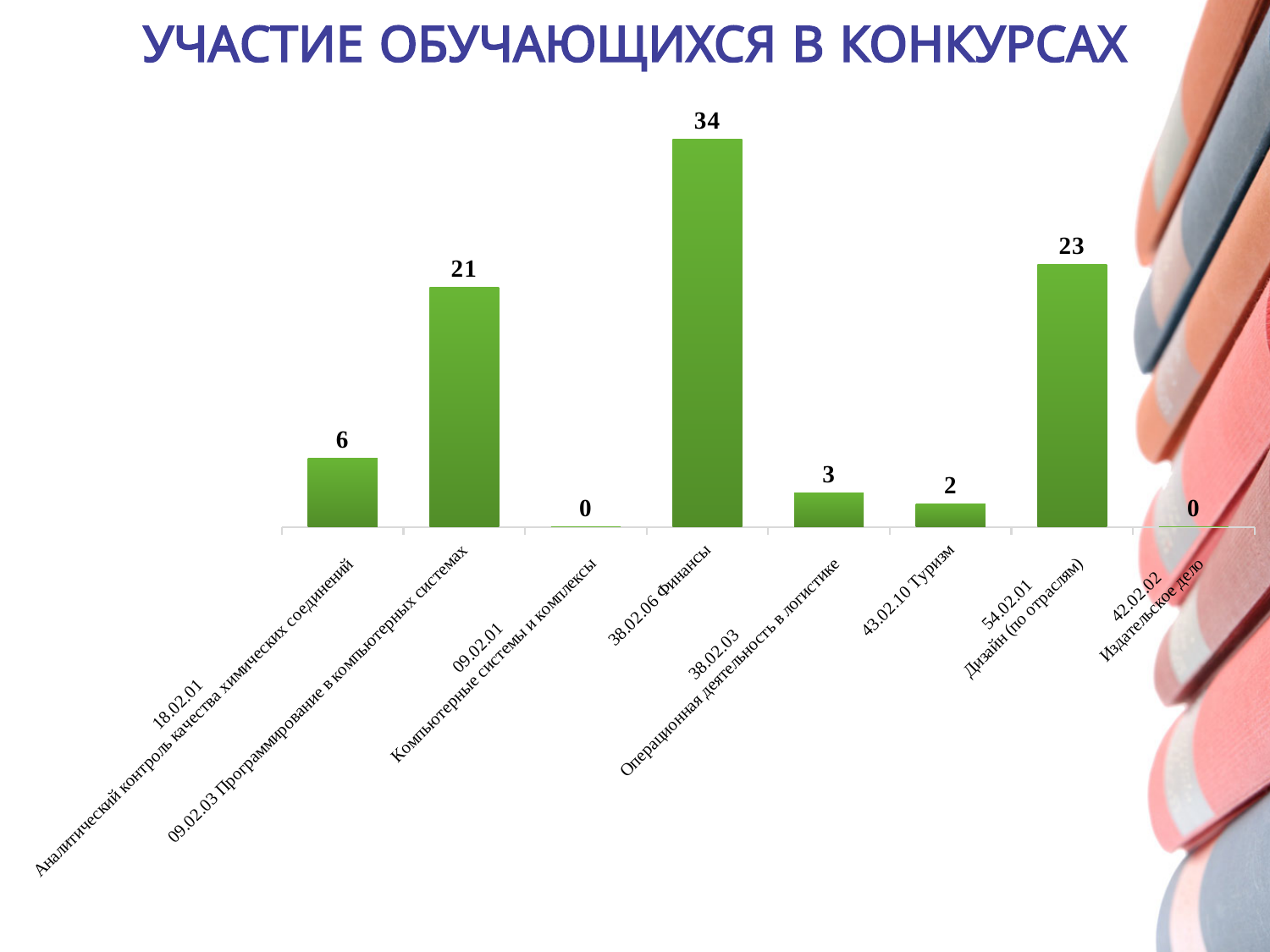
What is the value for 18.02.01 Аналитический контроль качества химических соединений? 6 Which is larger, the value for 38.02.03 Операционная деятельность в логистике or the value for 43.02.10 Туризм? 38.02.03 Операционная деятельность в логистике How many categories are shown on the x axis? 8 What is the value for 38.02.06 Финансы? 34 What is the value for 09.02.03 Программирование в компьютерных системах? 21 What kind of chart is shown on the slide? bar chart Which category has the highest value? 38.02.06 Финансы What is the difference between the values for 09.02.03 Программирование в компьютерных системах and 18.02.01 Аналитический контроль качества химических соединений? 15 What is the value for 43.02.10 Туризм? 2 What is the value for 54.02.01 Дизайн (по отраслям)? 23 What is the difference between the values for 38.02.06 Финансы and 54.02.01 Дизайн (по отраслям)? 11 What is the title of the chart? УЧАСТИЕ ОБУЧАЮЩИХСЯ В КОНКУРСАХ